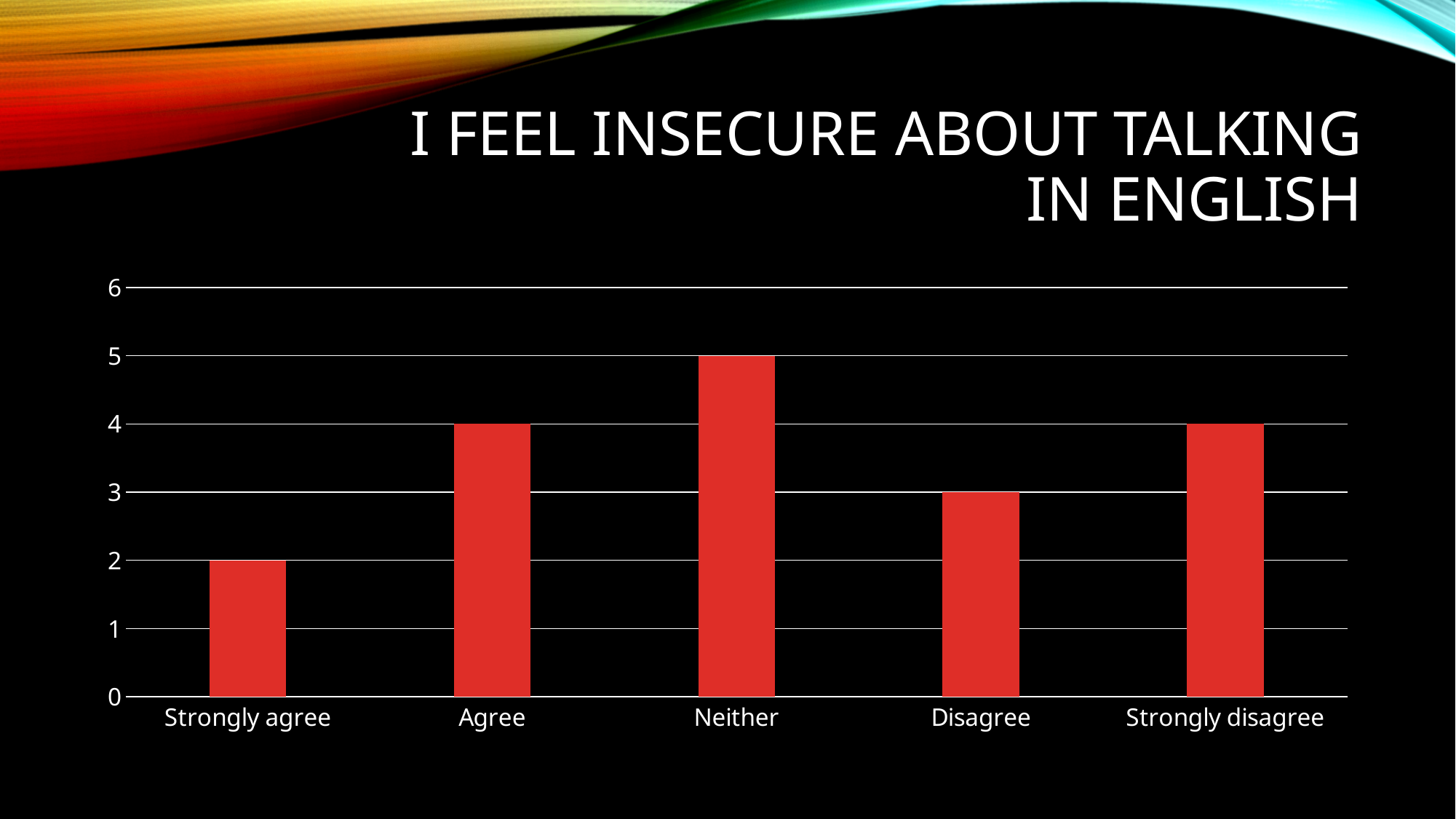
What kind of chart is shown on the slide? bar chart What is the title of the slide? I feel insecure about talking in English How many categories are shown on the x axis? 5 Is the value for Neither greater or less than 4? greater What is the value for Neither? 5 Which is larger, the value for Disagree or the value for Strongly disagree? Strongly disagree What is the difference between the values for Neither and Strongly agree? 3 What is the value for Disagree? 3 What is the value for Strongly agree? 2 Which category has the lowest value? Strongly agree Which category has the highest value? Neither What is the difference between the values for Agree and Disagree? 1